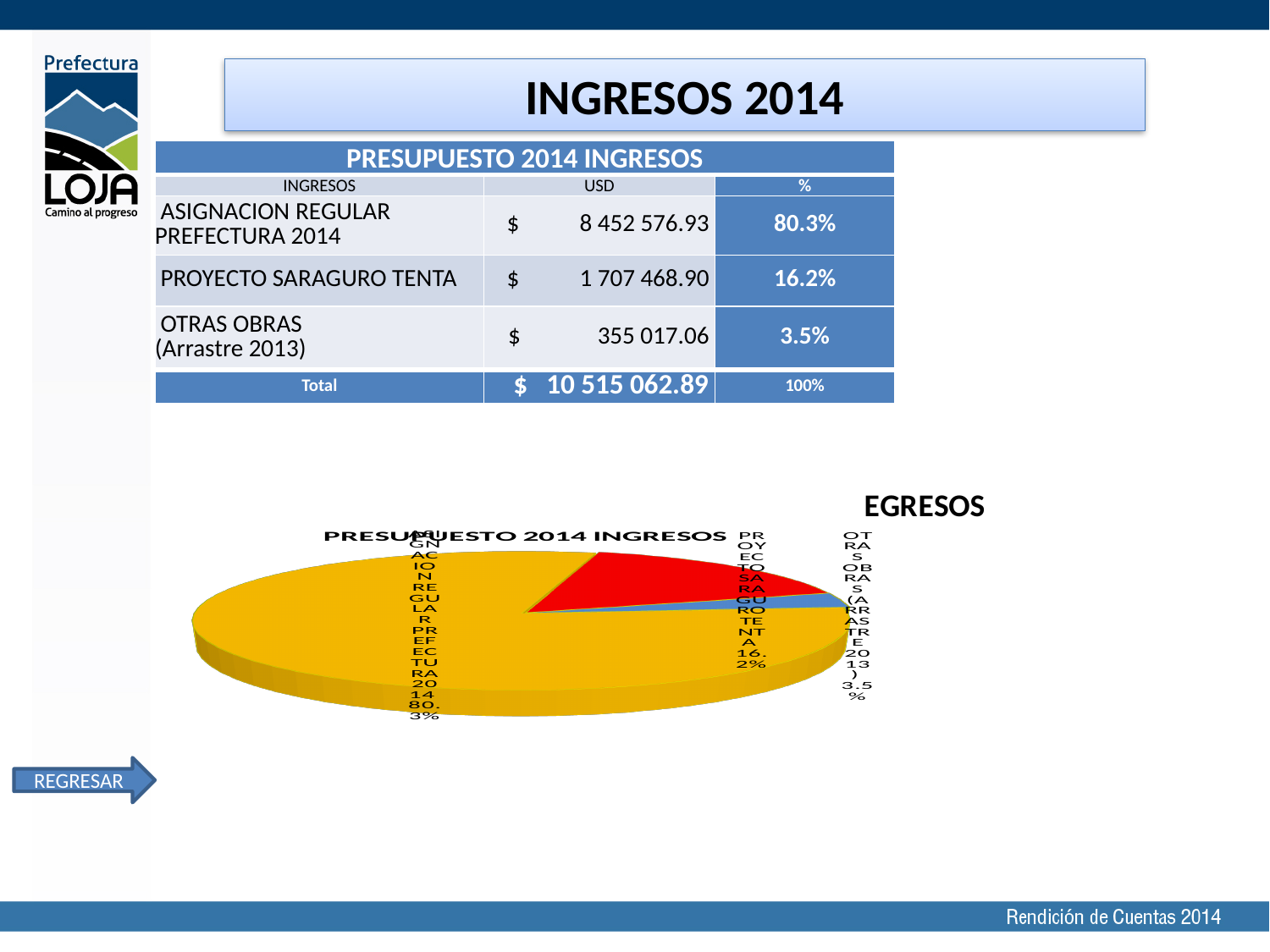
What kind of chart is shown on the slide? Pie chart What colour is the largest slice of the pie chart? Yellow What is the difference in percentage points between the PROYECTO SARAGURO TENTA slice and the OTRAS OBRAS (ARRASTRE 2013) slice? 12.7 percentage points Which is larger in the pie chart, PROYECTO SARAGURO TENTA or OTRAS OBRAS (ARRASTRE 2013)? PROYECTO SARAGURO TENTA What is the difference in percentage points between the ASIGNACION REGULAR PREFECTURA 2014 slice and the PROYECTO SARAGURO TENTA slice? 64.1 percentage points How many slices does the pie chart have? 3 What share of the pie does PROYECTO SARAGURO TENTA represent? 16.2% What share of the pie does OTRAS OBRAS (ARRASTRE 2013) represent? 3.5% Which slice of the pie chart is the largest? ASIGNACION REGULAR PREFECTURA 2014 What is the title of the pie chart? PRESUPUESTO 2014 INGRESOS Which slice of the pie chart is the smallest? OTRAS OBRAS (ARRASTRE 2013) What share of the pie does ASIGNACION REGULAR PREFECTURA 2014 represent? 80.3%